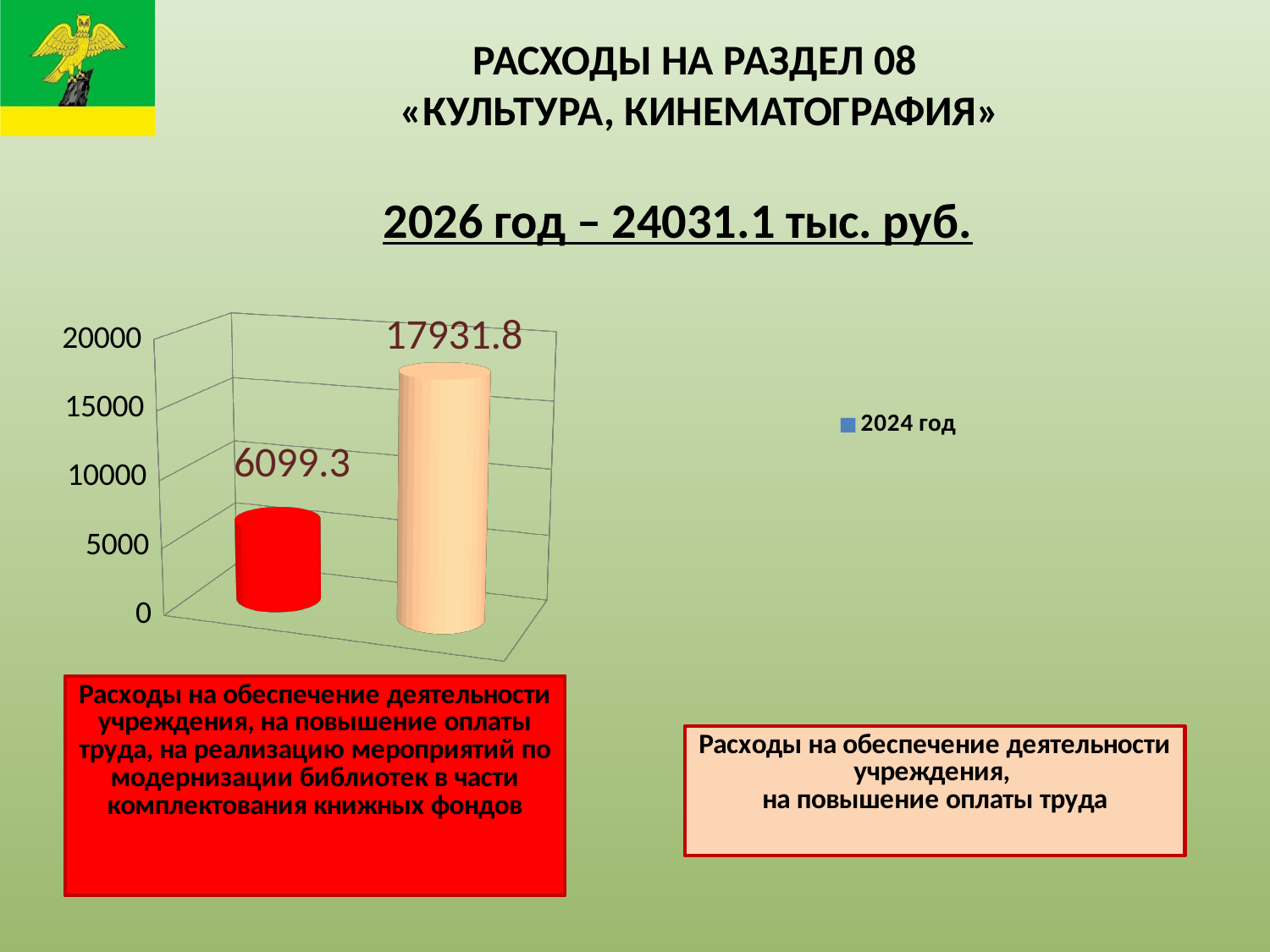
What is the difference between the peach-coloured bar (17931.8) and the red bar (6099.3)? 11832.5 What value is shown on the red bar? 6099.3 Which bar has the lowest value? the red bar What kind of chart is shown on the slide? bar chart How many bars are plotted in the chart? 2 Is the value for the red bar greater or less than 10000? less How many series does the chart legend list? 1 Is the value for the peach-coloured bar greater or less than 15000? greater Which bar has the highest value, the red one or the peach-coloured one? the peach-coloured bar Is the value of the red bar larger or smaller than the value of the peach-coloured bar? smaller What is the total of the two bar values shown in the chart? 24031.1 What value is shown on the peach-coloured bar? 17931.8